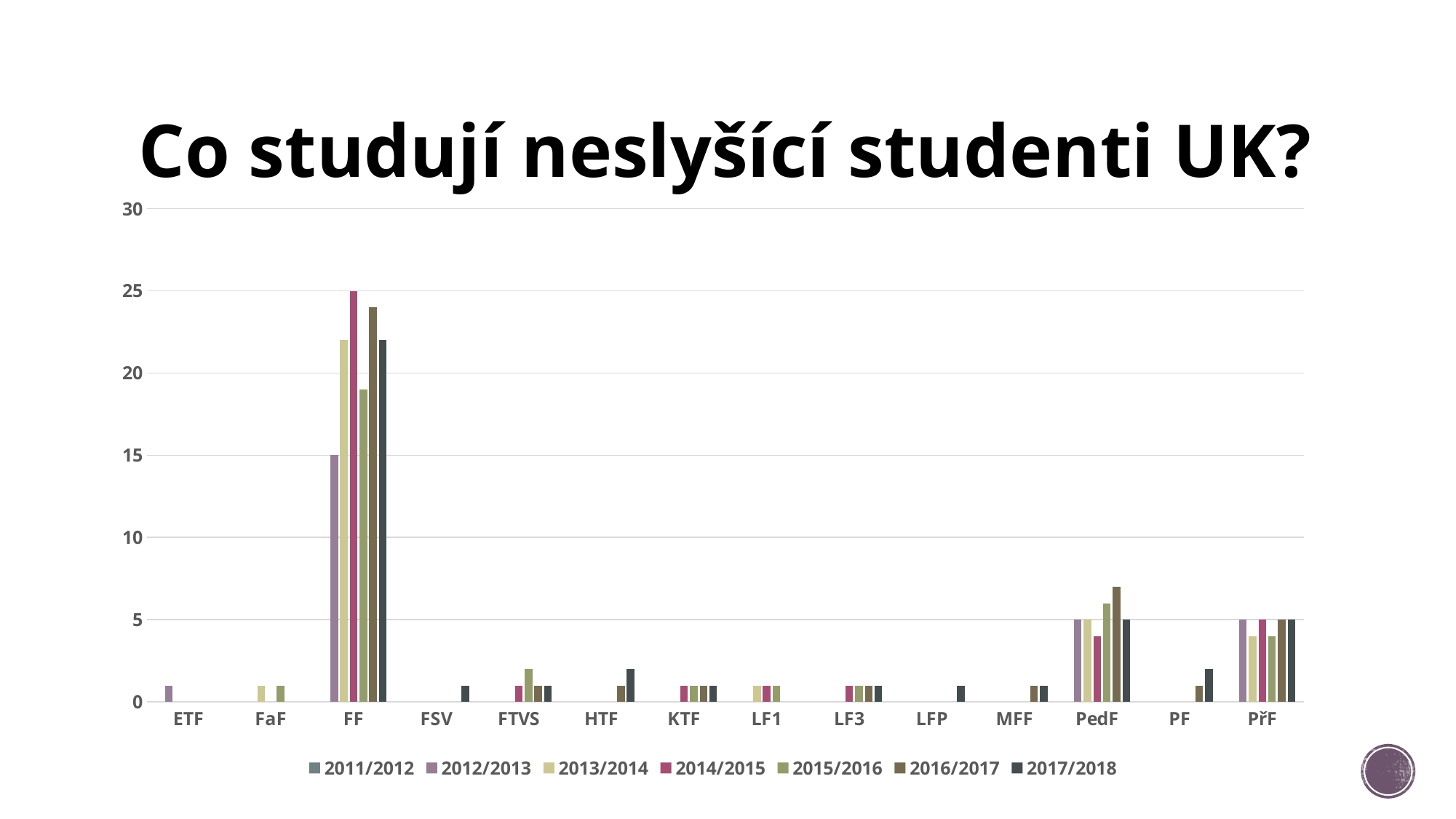
Is the value for PedF in 2016/2017 greater or less than 5? greater What is the value for FF in 2014/2015? 25 What kind of chart is shown on the slide? bar chart Is the value for PedF in 2014/2015 greater or less than 5? less Which is larger for FF: the value for 2014/2015 or the value for 2012/2013? 2014/2015 How many categories are shown on the x axis? 14 Is the value for FF in 2016/2017 greater or less than 20? greater What is the value for FF in 2012/2013? 15 Which category has the highest bars overall? FF What is the title of the chart? Co studují neslyšící studenti UK? What is the value for PedF in 2017/2018? 5 How many series does the legend list? 7